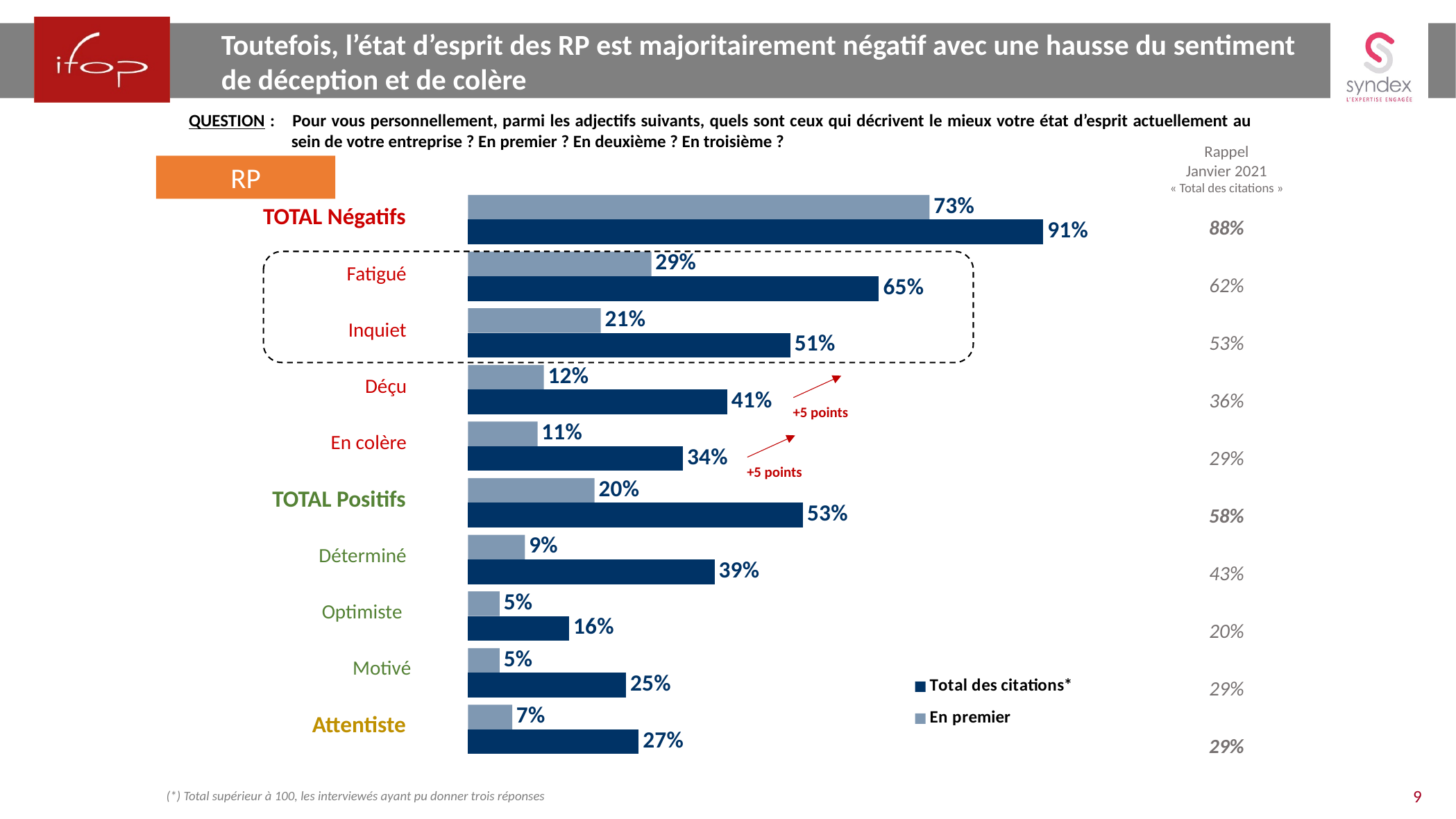
What is the difference between the 'Total des citations*' values for Déçu and En colère? 7 points What type of chart is shown on the slide? Bar chart How many series does the legend list? 2 Which category has the lowest 'Total des citations*' value? Optimiste How many categories are shown in the chart? 10 Which category has the highest 'Total des citations*' value? TOTAL Négatifs What is the 'Total des citations*' value for Fatigué? 65% What is the 'En premier' value for Attentiste? 7% Which is larger: the 'Total des citations*' value for Motivé or for Attentiste? Attentiste What is the 'En premier' value for Inquiet? 21% What is the 'Total des citations*' value for TOTAL Positifs? 53% What is the 'Rappel Janvier 2021' value shown for Déterminé? 43%